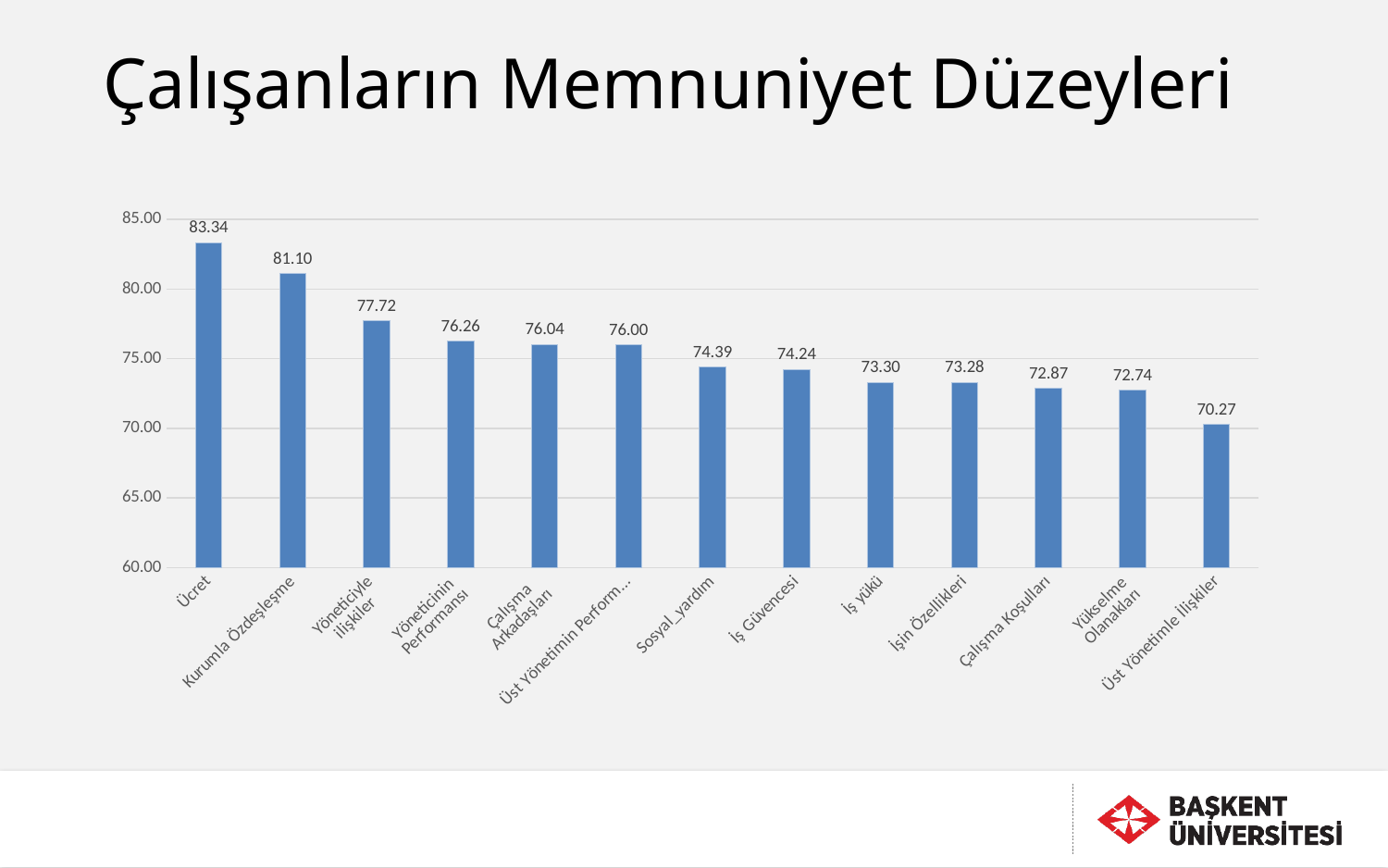
How many categories are shown in the chart? 13 Which category has the lowest value? Üst Yönetimle İlişkiler What is the difference between the values for Ücret and Kurumla Özdeşleşme? 2.24 What kind of chart is shown on the slide? bar chart Which is larger, the value for İş Güvencesi or the value for İş yükü? İş Güvencesi What is the value for Ücret? 83.34 What is the value for Sosyal_yardım? 74.39 Is the value for Yükselme Olanakları greater or less than 75.00? less Do the values rise or fall from left to right along the x axis? fall What is the value for Çalışma Koşulları? 72.87 What is the difference between the values for Yöneticiyle İlişkiler and Üst Yönetimle İlişkiler? 7.45 Which category has the highest value? Ücret